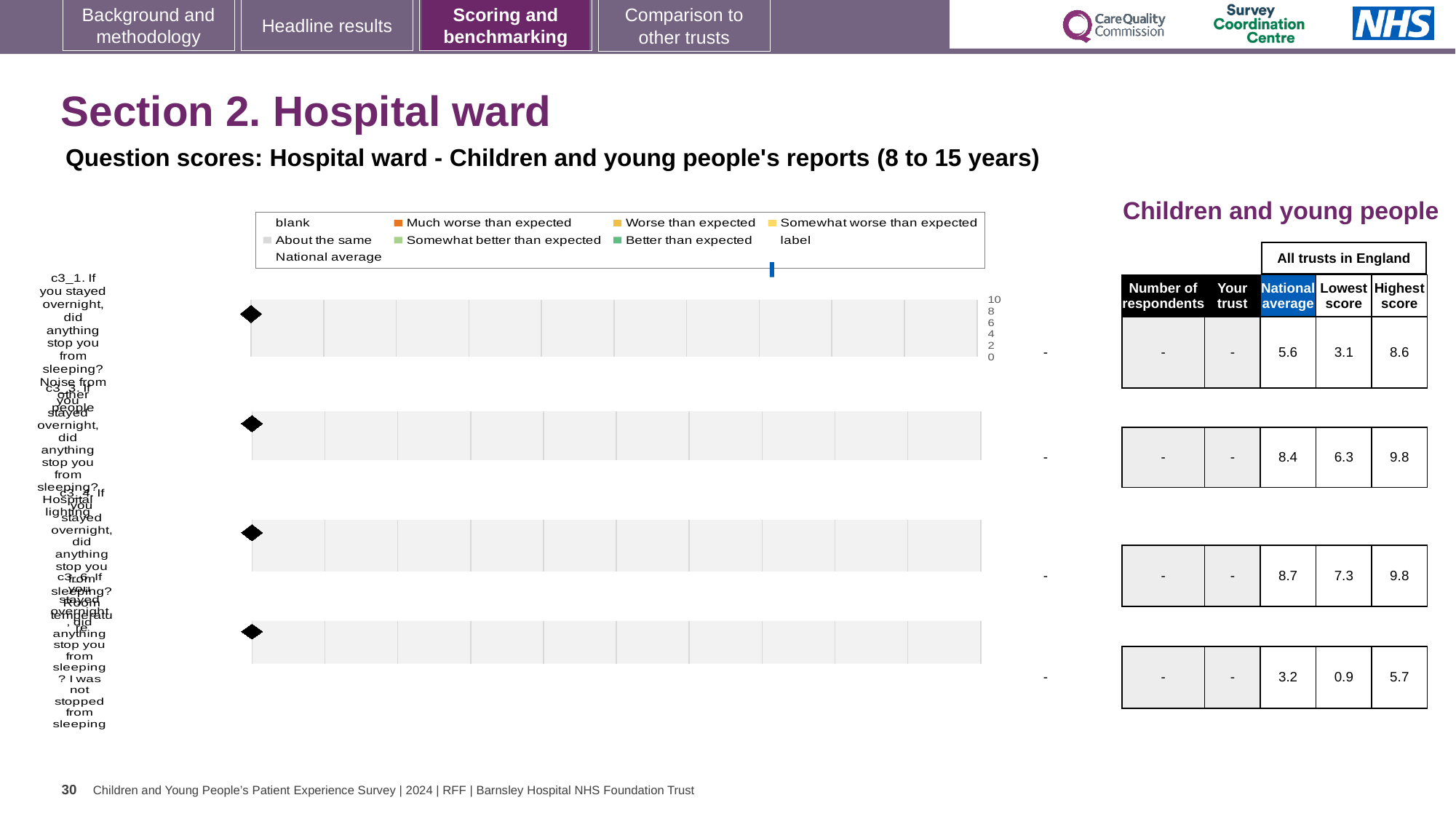
In the table beside the chart, which row has the highest National average? the third row (8.7) In the table beside the chart, what is the Highest score for the second row? 9.8 In the table beside the chart, which row has the lowest National average? the fourth row (3.2) How many question rows (bars) does the chart contain? 4 In the table beside the chart, what is the Lowest score for the fourth row? 0.9 In the table beside the chart, is the National average of the second row larger or smaller than that of the third row? smaller What is the maximum value shown on the chart's numeric axis? 10 In the table beside the chart, what is the difference between the Highest score and Lowest score in the first row? 5.5 In the table beside the chart, what is the National average for the first row? 5.6 In the table beside the chart, what value is shown for 'Your trust' in each row? - What colour does the legend use for 'Much worse than expected'? orange What kind of chart is shown on the slide? bar chart